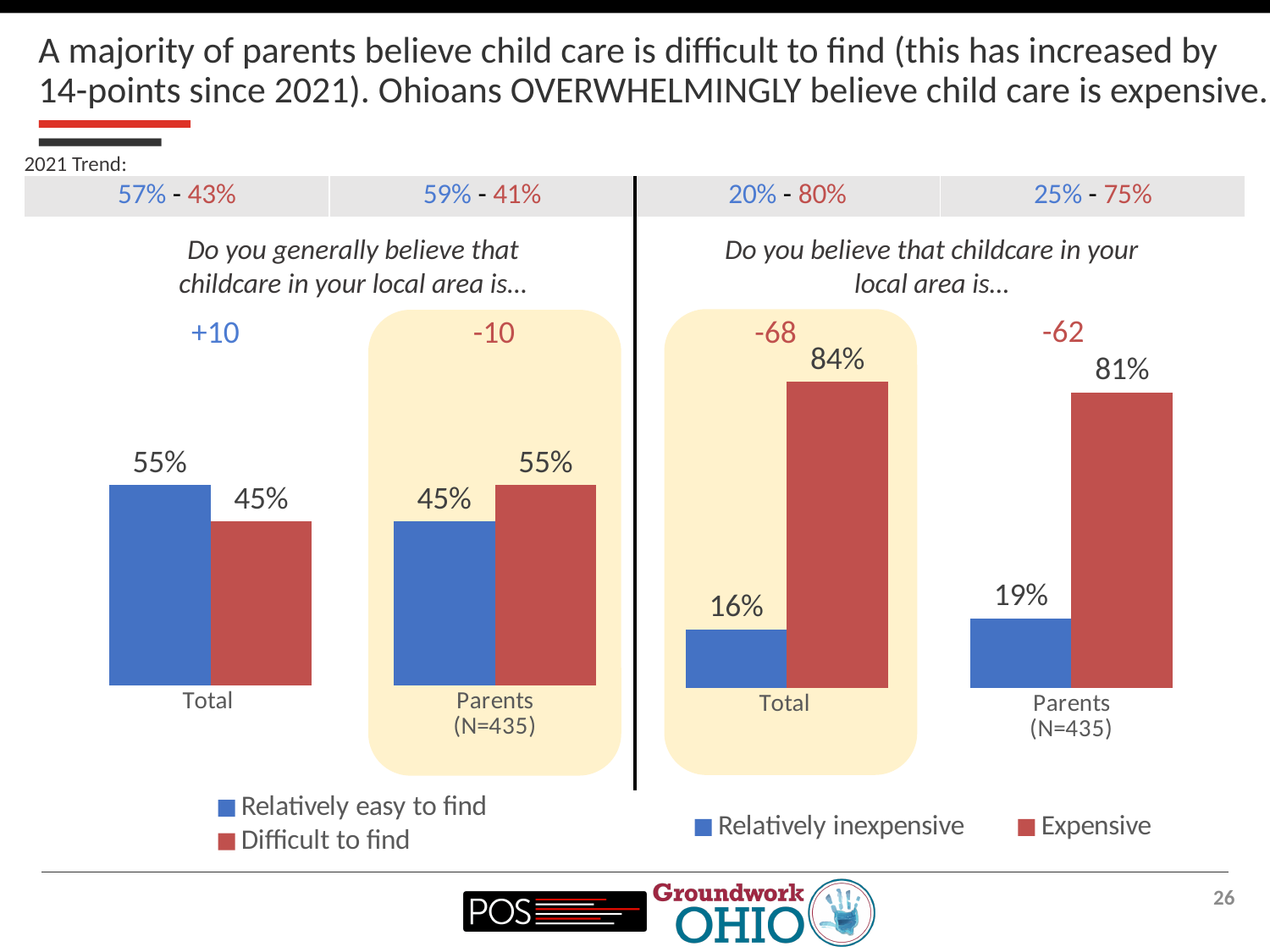
In the right chart (childcare is inexpensive or expensive), which category has the highest value for Expensive? Total In the left chart (childcare is easy or difficult to find), what is the difference between Relatively easy to find and Difficult to find for the Total group? 10 In the left chart (childcare is easy or difficult to find), what percentage of Parents said childcare is difficult to find? 55% What type of chart is the right chart (childcare is inexpensive or expensive)? Bar chart In the right chart (childcare is inexpensive or expensive), what is the difference between the Expensive and Relatively inexpensive values for the Total group? 68 In the right chart (childcare is inexpensive or expensive), what percentage of Parents said childcare is relatively inexpensive? 19% In the left chart (childcare is easy or difficult to find), what colour represents Difficult to find? Red In the left chart (childcare is easy or difficult to find), which is larger for Parents: Relatively easy to find or Difficult to find? Difficult to find How many categories are shown on the x axis of the left chart (childcare is easy or difficult to find)? 2 How many series does the legend of the right chart (childcare is inexpensive or expensive) list? 2 In the left chart (childcare is easy or difficult to find), what percentage of the Total group said childcare is relatively easy to find? 55% In the right chart (childcare is inexpensive or expensive), what percentage of the Total group said childcare is expensive? 84%